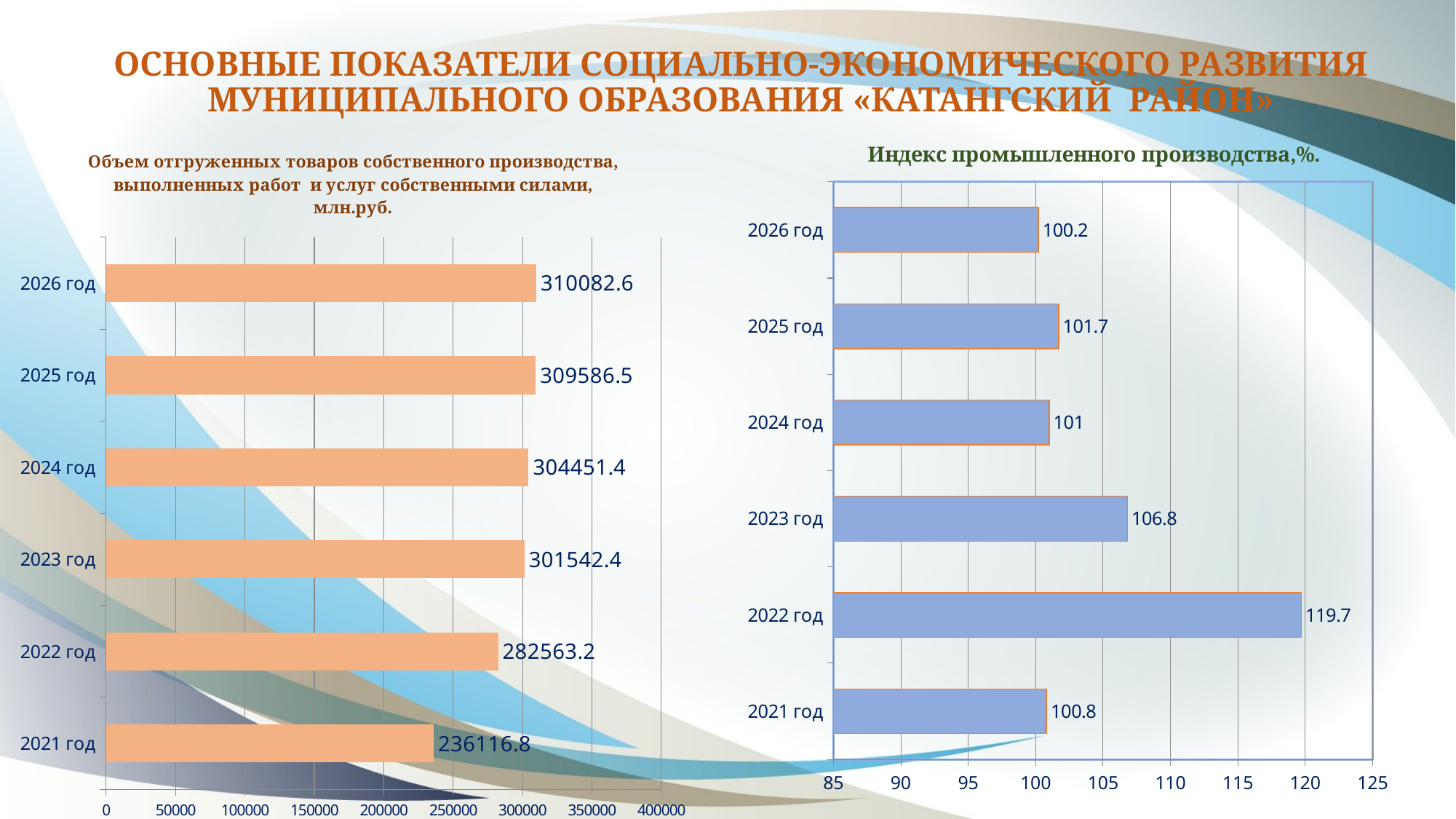
In the right chart (Индекс промышленного производства), which year has the lowest value? 2026 год In the right chart (Индекс промышленного производства), which year has the highest value? 2022 год How many years are shown in the left chart (Объем отгруженных товаров)? 6 In the left chart (Объем отгруженных товаров), what is the difference between the values for 2022 год and 2021 год? 46446.4 In the left chart (Объем отгруженных товаров), which year has the lowest value? 2021 год In the right chart (Индекс промышленного производства), what is the value for 2024 год? 101 In the left chart (Объем отгруженных товаров), what is the value for 2021 год? 236116.8 In the right chart (Индекс промышленного производства), what is the difference between the values for 2022 год and 2023 год? 12.9 In the left chart (Объем отгруженных товаров), what is the value for 2026 год? 310082.6 In the right chart (Индекс промышленного производства), what is the value for 2022 год? 119.7 What type of chart is the right chart (Индекс промышленного производства)? Bar chart In the right chart (Индекс промышленного производства), which is larger: the value for 2023 год or the value for 2025 год? 2023 год